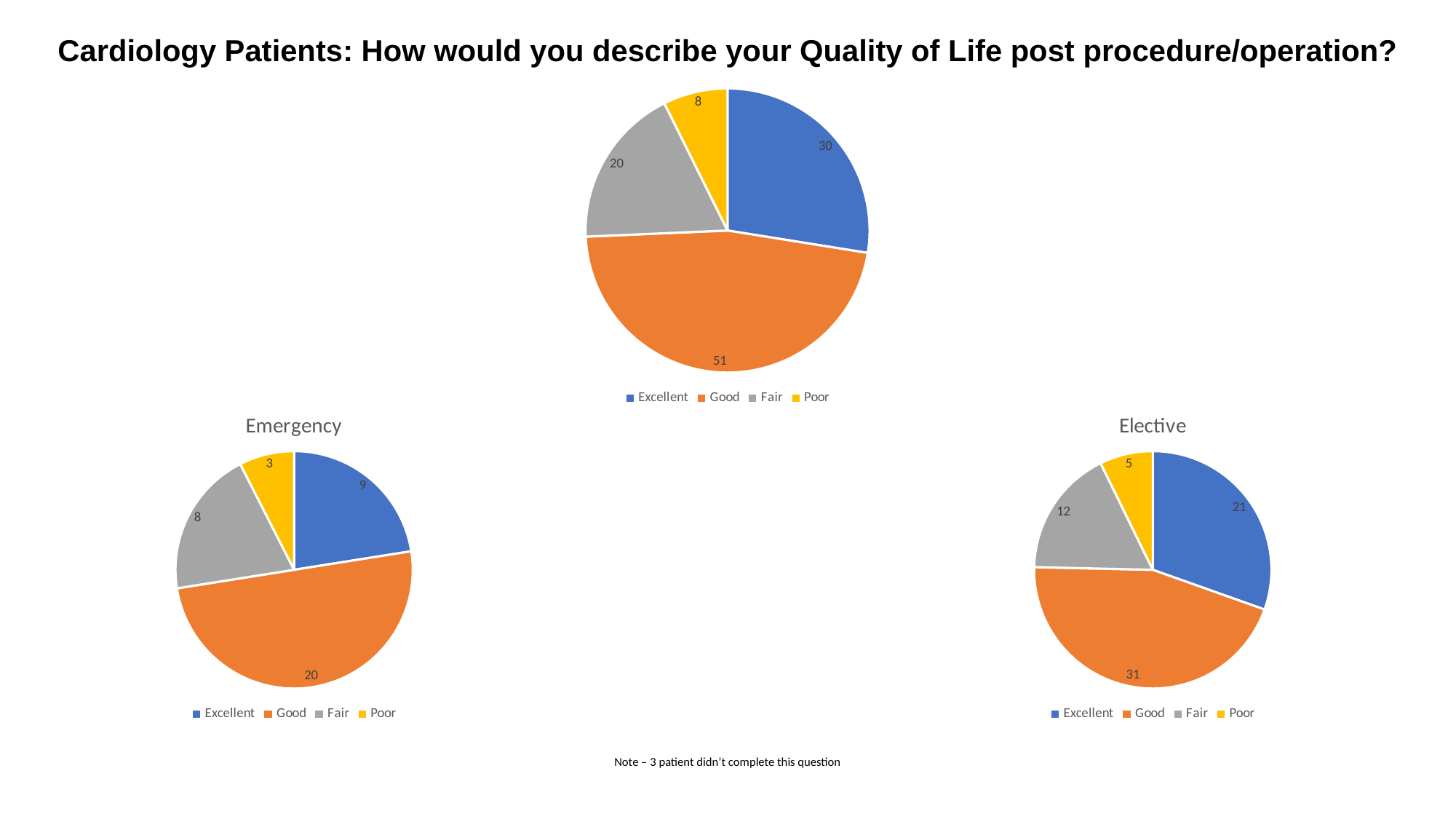
How many slices does the Emergency pie chart have? 4 In the Elective pie chart, which category has the smallest slice? Poor In the top pie chart, which colour represents Poor? Yellow What type of chart is the Emergency chart? Pie chart In the top pie chart, what is the value for Good? 51 In the Emergency pie chart, what is the value for Fair? 8 In the top pie chart, which category has the largest slice? Good In the Emergency pie chart, what share of the total does the Good slice represent? 50% In the Elective pie chart, what is the value for Excellent? 21 In the Emergency pie chart, what is the difference between the Good and Excellent values? 11 In the Elective pie chart, which is larger, Fair or Poor? Fair How many entries does the legend of the Elective pie chart list? 4